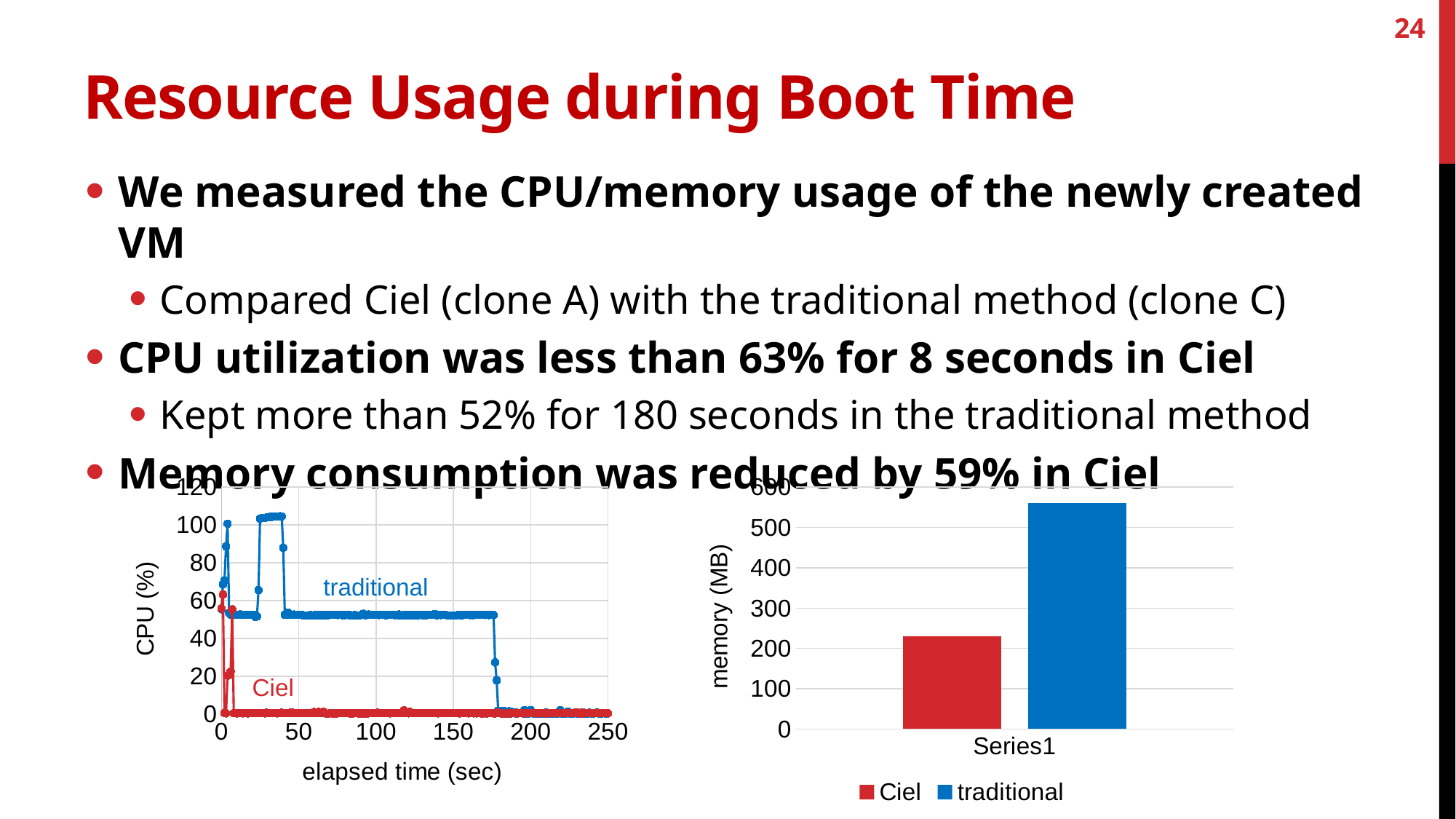
In the CPU (%) chart on the left, which series stays at a higher CPU level between 50 and 150 seconds, traditional or Ciel? traditional In the CPU (%) chart on the left, what is the label of the x axis? elapsed time (sec) What kind of chart is the chart on the left of the slide (CPU (%) vs elapsed time)? line chart In the memory (MB) chart on the right, is the value for Ciel greater or less than 300? less In the memory (MB) chart on the right, is the value for Ciel greater or less than 200? greater In the memory (MB) chart on the right, which series has the lower memory consumption? Ciel In the memory (MB) chart on the right, is the value for traditional greater or less than 500? greater What kind of chart is the chart on the right of the slide (memory (MB))? bar chart In the memory (MB) chart on the right, how many series does the legend list? 2 In the memory (MB) chart on the right, which series has the higher memory consumption? traditional In the memory (MB) chart on the right, how many bars are plotted? 2